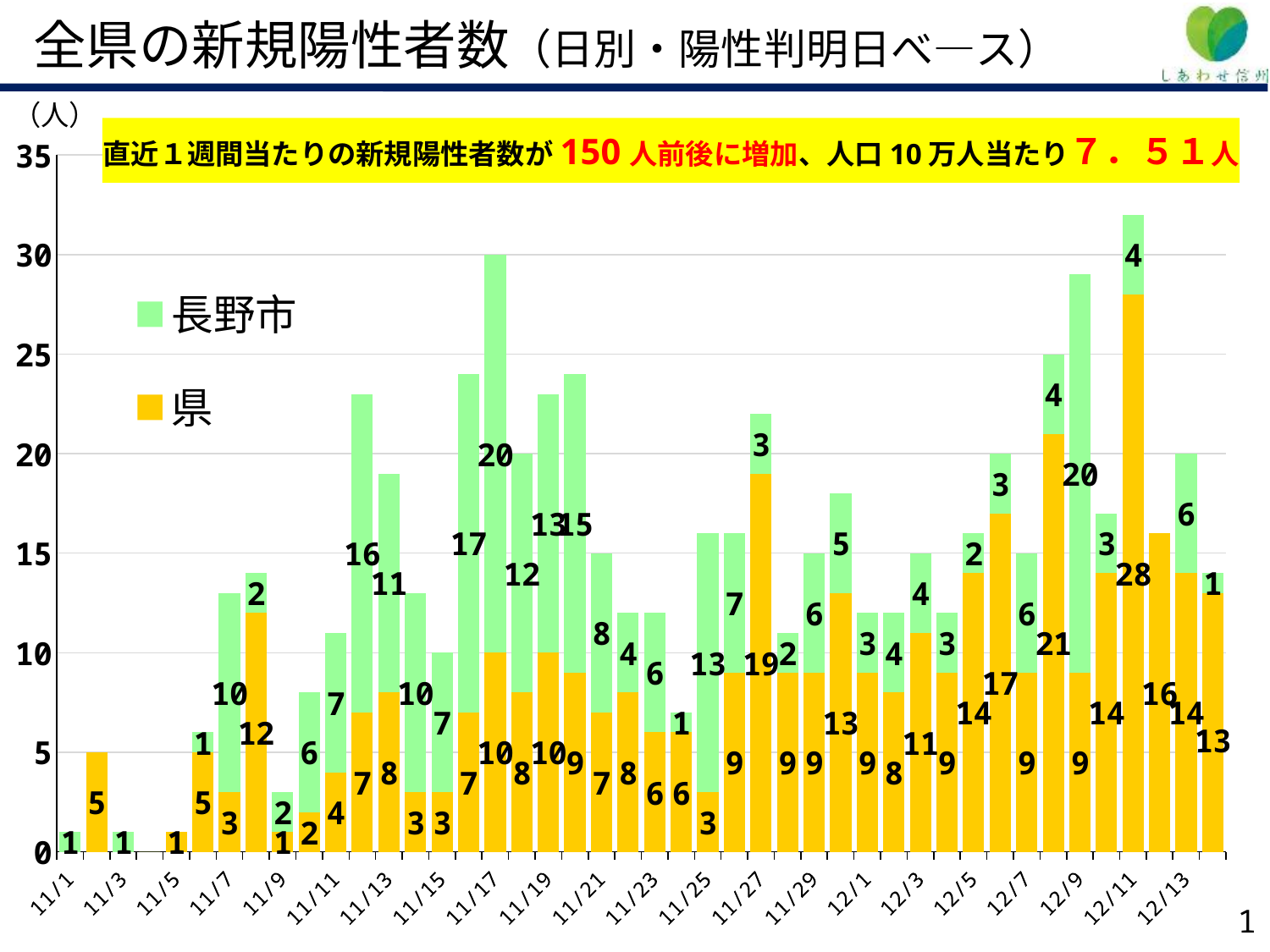
What kind of chart is shown on the slide? Stacked bar chart What is the value for 長野市 on 11/17? 20 What is the total of the stacked bar for 11/17? 30 Which is larger, the 県 value on 12/11 or the 県 value on 11/27? 12/11 What is the value for 県 on 11/27? 19 What is the total of the stacked bar for 12/11? 32 What is the value for 県 on 12/11? 28 How many series does the legend list? 2 Which date has the highest total stacked bar? 12/11 What is the value for 長野市 on 12/11? 4 What is the difference between the 県 value on 12/11 and the 県 value on 12/8? 7 What are the two series named in the legend? 長野市 and 県